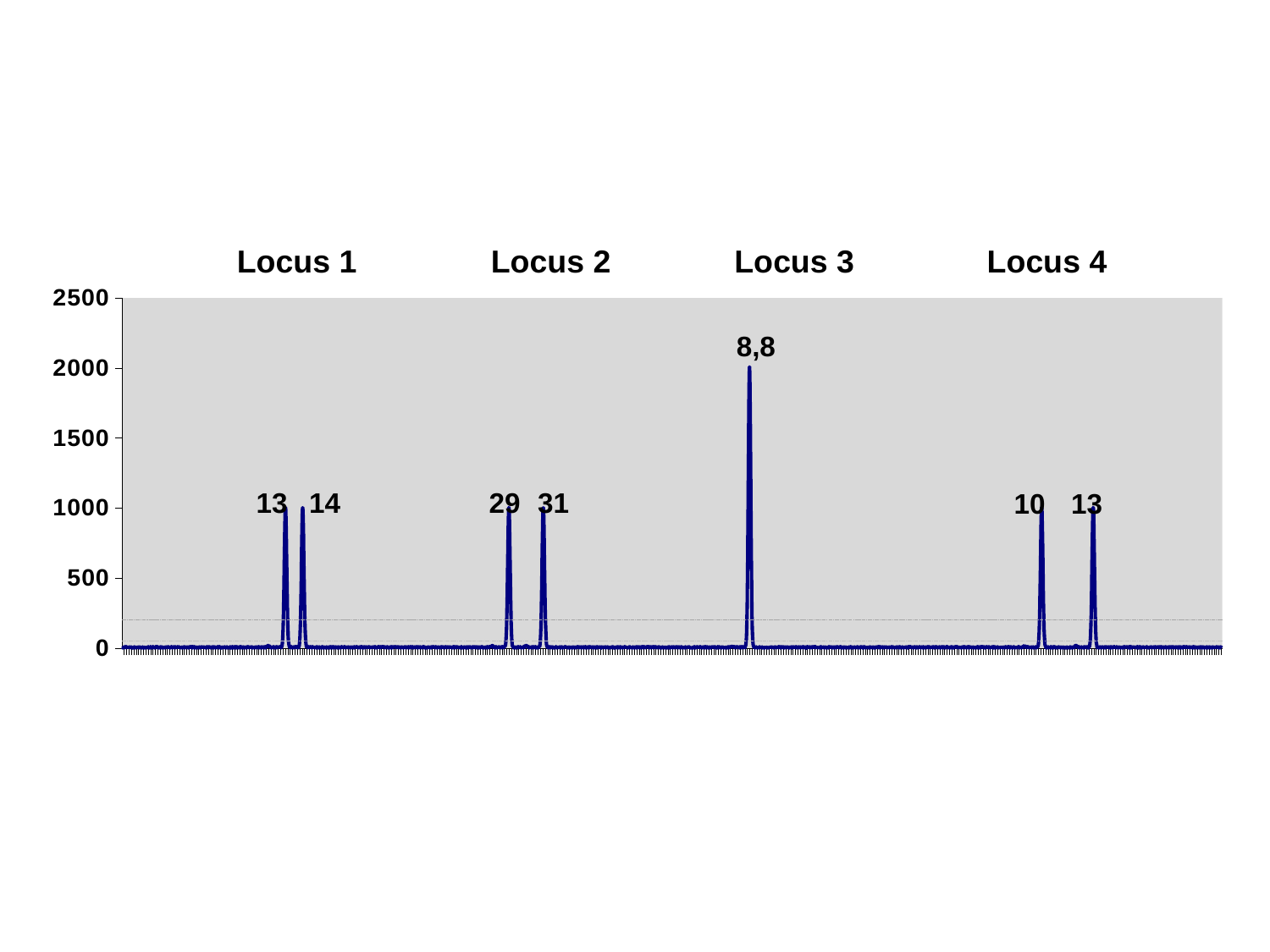
What are the labels on the two peaks at Locus 1? 13 and 14 Which has a taller peak, Locus 3 or Locus 2? Locus 3 How many loci are labelled above the chart? 4 Are the peaks at Locus 1 greater or less than 1500? less Are the peaks at Locus 4 greater or less than 500? greater How many peaks are shown in total across all loci? 7 What label is printed above the peak at Locus 3? 8,8 What kind of chart is shown on the slide? line chart Which locus has the tallest peak? Locus 3 Is the peak at Locus 3 greater or less than 1500? greater How many peaks are shown at Locus 4? 2 What is the highest value shown on the y axis? 2500